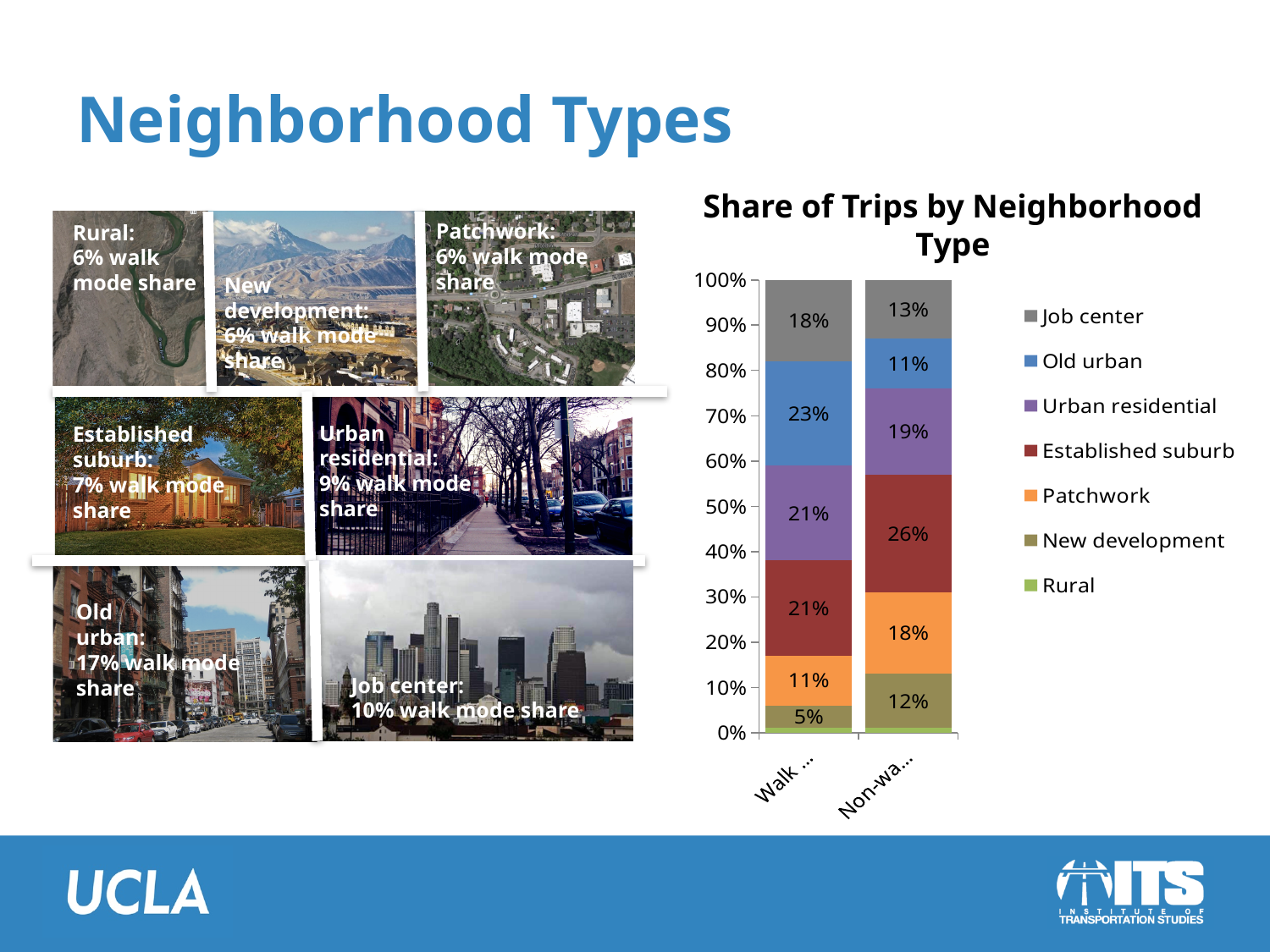
What is the title of the chart? Share of Trips by Neighborhood Type In the right bar (labeled 'Non-wa...'), what share is shown for New development? 12% What type of chart is shown on the slide? Stacked bar chart What is the difference between the Old urban share in the left bar (23%) and in the right bar (11%)? 12 percentage points In the left bar (labeled 'Walk ...'), what share is shown for Patchwork? 11% Is the Job center share larger in the left bar (labeled 'Walk ...') or the right bar (labeled 'Non-wa...')? Left bar (Walk ...) How many stacked bars are plotted in the chart? 2 Which legend entry is listed first, at the top of the legend? Job center Which neighborhood type has the largest labeled segment in the right bar (labeled 'Non-wa...')? Established suburb How many series does the chart's legend list? 7 In the right bar (labeled 'Non-wa...'), what share is shown for Established suburb? 26% In the left bar (labeled 'Walk ...'), what share is shown for Old urban? 23%